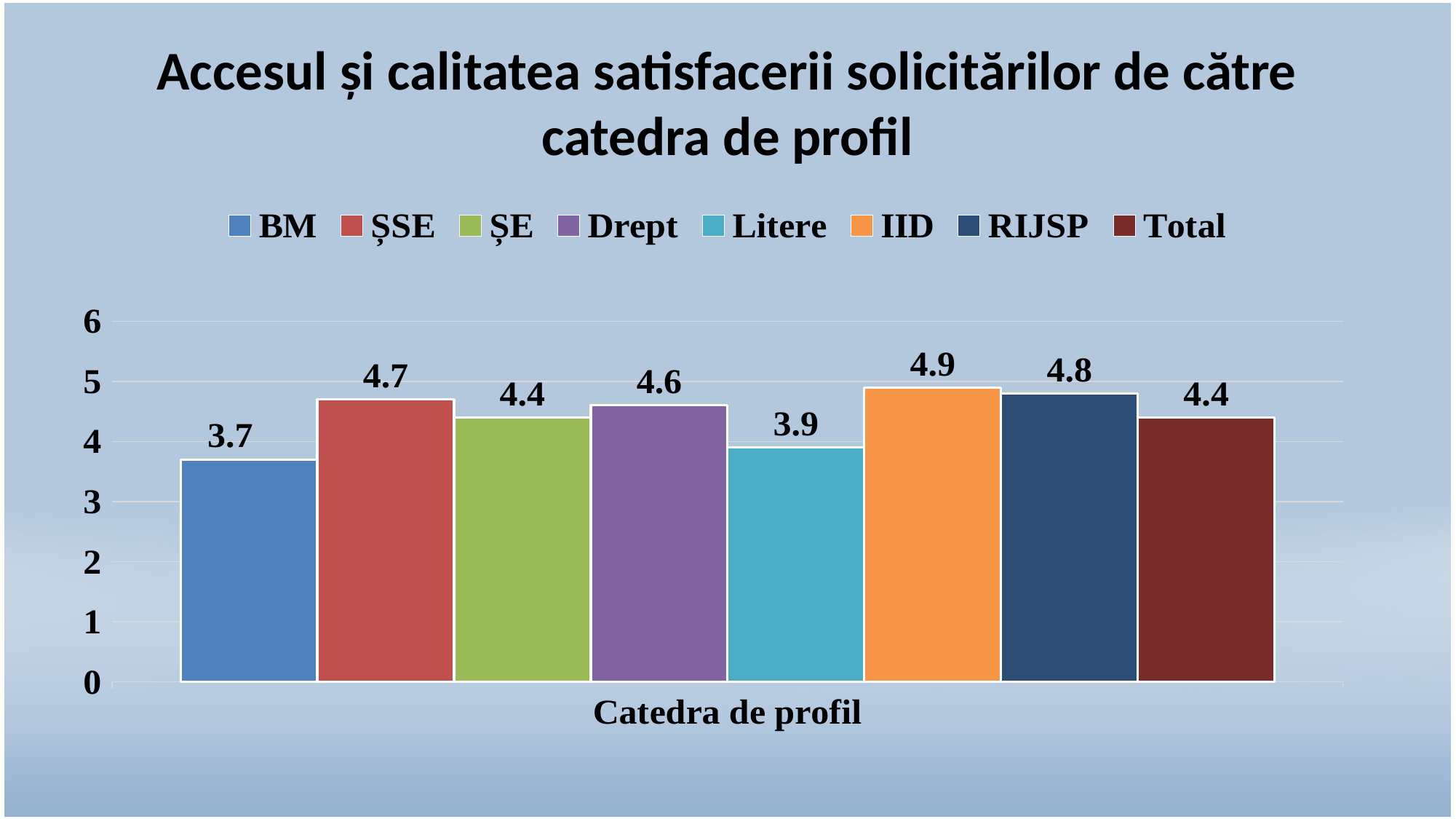
What is the difference between the values for IID and BM? 1.2 What is the value for BM? 3.7 What is the label of the horizontal axis? Catedra de profil Which is larger, the value for ȘSE or the value for Drept? ȘSE What is the value for Litere? 3.9 How many series does the legend list? 8 What is the value for IID? 4.9 Is the value for RIJSP greater or less than 4? greater Which series has the lowest value? BM What kind of chart is shown on the slide? bar chart Which series has the highest value? IID What is the value for Total? 4.4